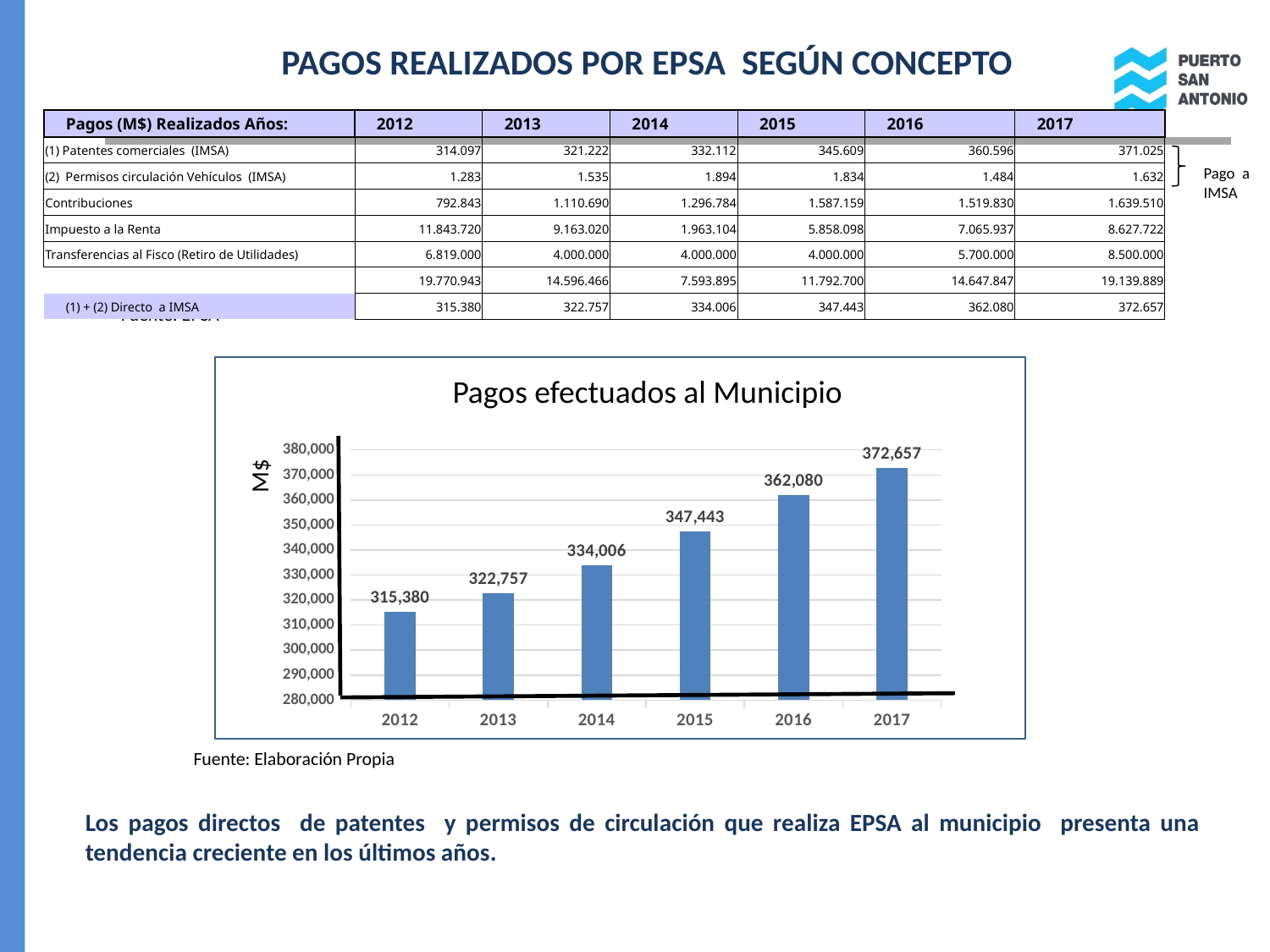
Which year has the lowest value in the chart? 2012 How many years are plotted in the chart? 6 Which is larger, the value for 2014 or the value for 2013? 2014 What is the difference between the values for 2017 and 2012? 57,277 What is the value for 2017 in the chart? 372,657 What is the title of the chart? Pagos efectuados al Municipio What is the value for 2012 in the chart? 315,380 What is the value for 2015 in the chart? 347,443 Do the values rise or fall from 2012 to 2017? Rise Which year has the highest value in the chart? 2017 What is the difference between the values for 2016 and 2015? 14,637 What type of chart is shown on the slide? Bar chart